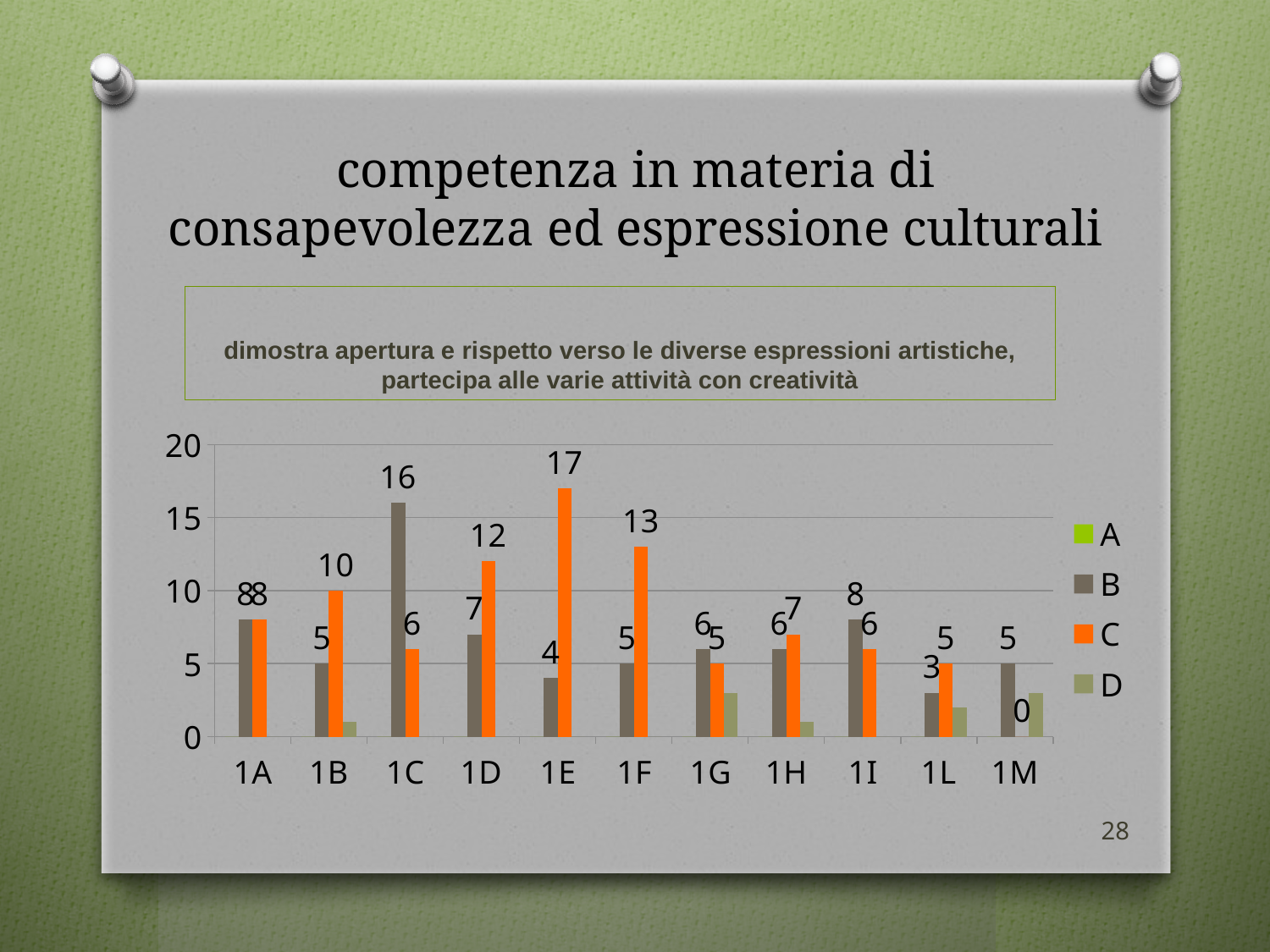
What kind of chart is shown on the slide? bar chart What is the value of series B for category 1C? 16 What is the value of series C for category 1E? 17 What is the difference between series C and series B for category 1E? 13 Which category has the highest value for series B? 1C How many categories are shown on the x axis? 11 What are the entries listed in the legend? A, B, C, D How many series does the legend list? 4 Is the value of series D for category 1G greater or less than 5? less Which category has the highest value for series C? 1E What is the value of series C for category 1M? 0 For category 1D, which is larger: series B or series C? C